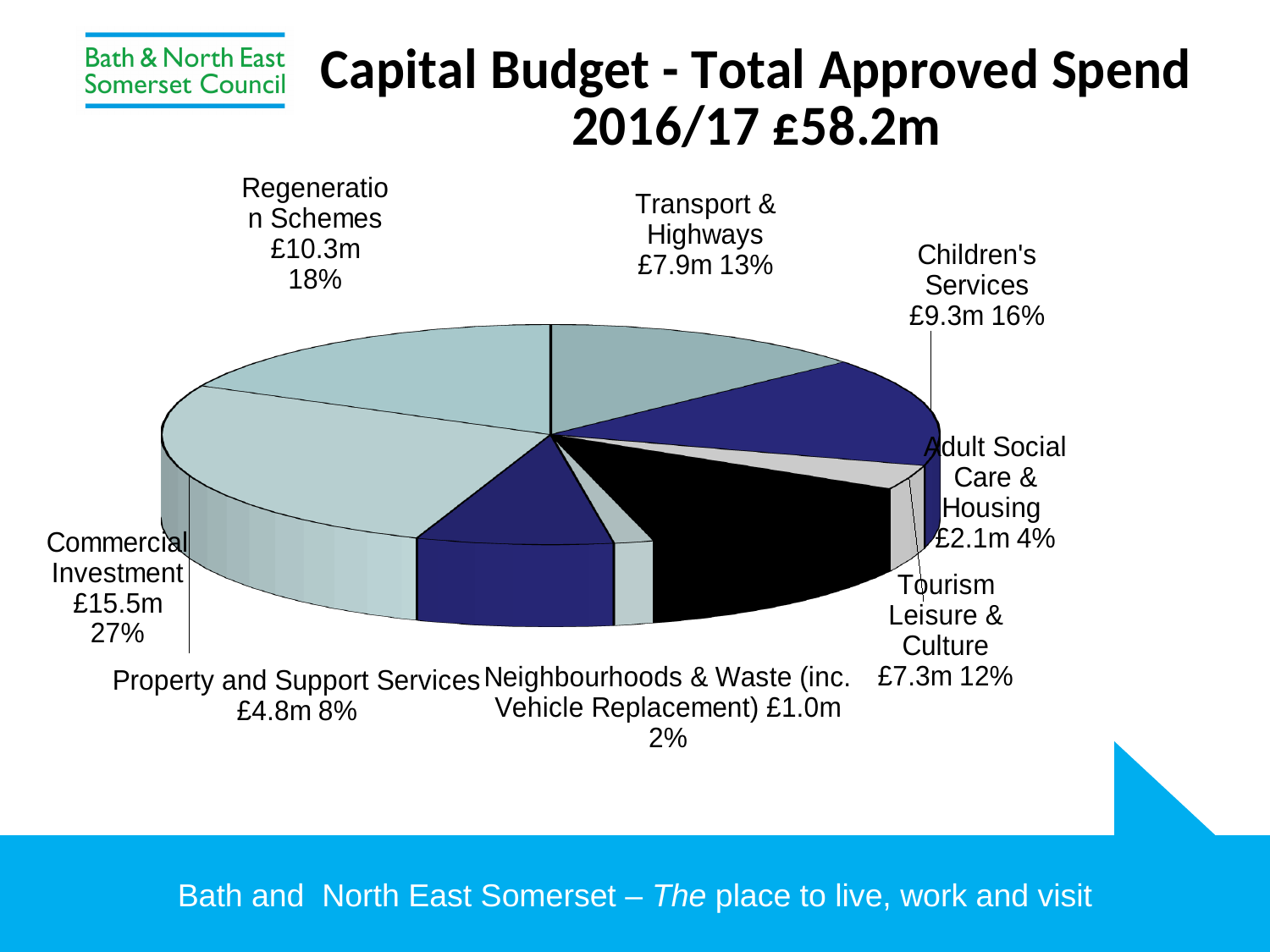
What is the title of the chart? Capital Budget - Total Approved Spend 2016/17 £58.2m What percentage share does Transport & Highways have? 13% What share of the pie does Regeneration Schemes represent? 18% Which category has the smallest approved spend? Neighbourhoods & Waste (inc. Vehicle Replacement) What is the approved spend for Commercial Investment? £15.5m What is the approved spend for Children's Services? £9.3m How many categories are shown in the pie chart? 8 What type of chart is shown on the slide? Pie chart Which category has the largest approved spend? Commercial Investment Which has a larger approved spend, Transport & Highways or Tourism Leisure & Culture? Transport & Highways What is the difference in approved spend between Commercial Investment and Regeneration Schemes? £5.2m What is the approved spend for Adult Social Care & Housing? £2.1m